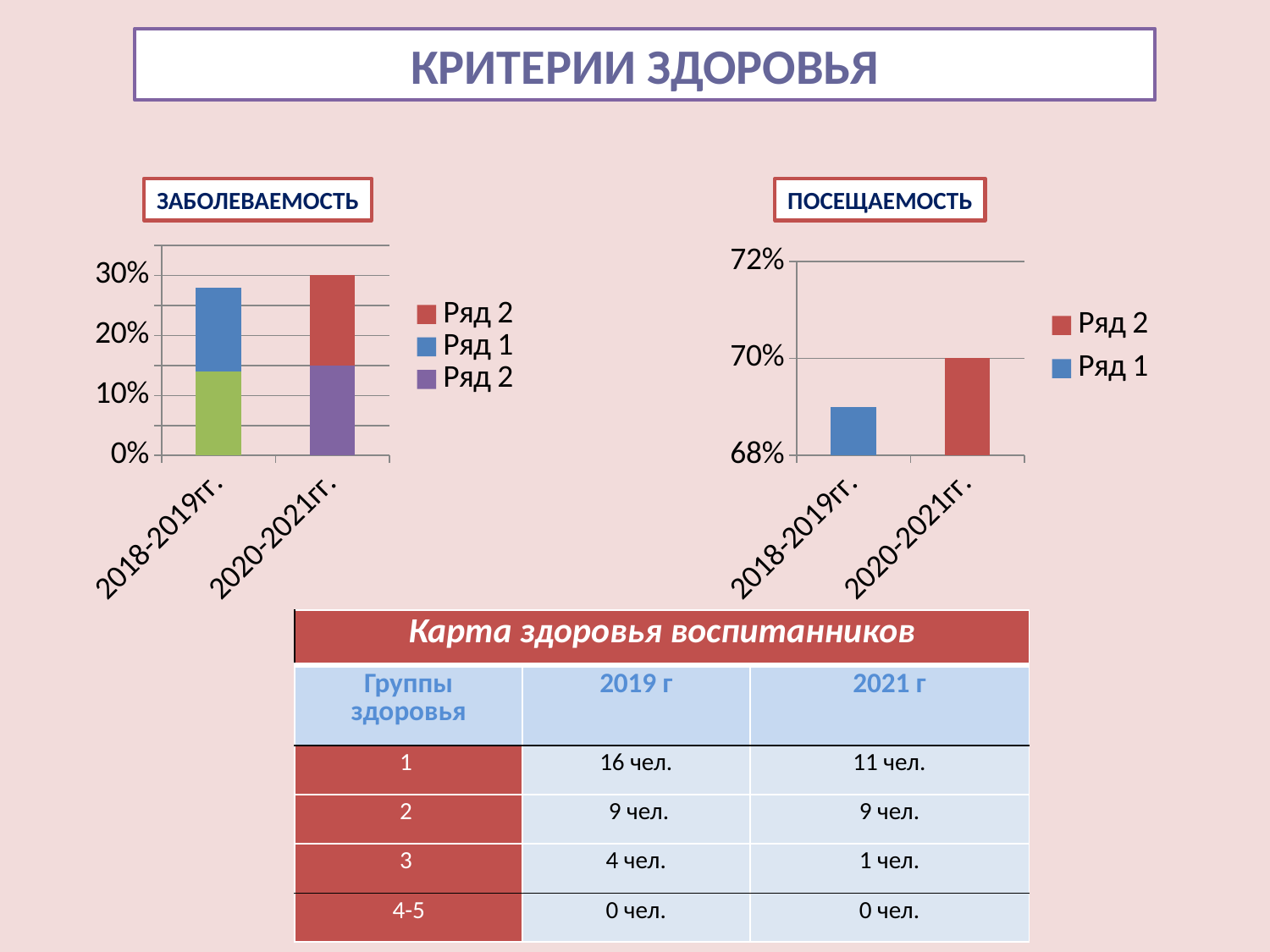
In the ЗАБОЛЕВАЕМОСТЬ chart, which category has the taller stacked bar? 2020-2021гг. In the ЗАБОЛЕВАЕМОСТЬ chart, is the total height of the stacked bar for 2018-2019гг. greater or less than 20%? greater How many entries does the legend of the ЗАБОЛЕВАЕМОСТЬ chart list? 3 In the ЗАБОЛЕВАЕМОСТЬ chart, is the total height of the stacked bar for 2020-2021гг. greater or less than 20%? greater What colour is the bar for 2018-2019гг. in the ПОСЕЩАЕМОСТЬ chart? blue How many categories are shown on the x axis of the ЗАБОЛЕВАЕМОСТЬ chart? 2 In the ПОСЕЩАЕМОСТЬ chart, is the value for 2018-2019гг. greater or less than 70%? less How many series does the legend of the ПОСЕЩАЕМОСТЬ chart list? 2 In the ПОСЕЩАЕМОСТЬ chart, do the values rise or fall from 2018-2019гг. to 2020-2021гг.? rise What kind of chart is the ЗАБОЛЕВАЕМОСТЬ chart on the left? bar chart In the ПОСЕЩАЕМОСТЬ chart, what value does the bar for 2020-2021гг. reach? 70% In the ПОСЕЩАЕМОСТЬ chart, which category has the higher bar? 2020-2021гг.